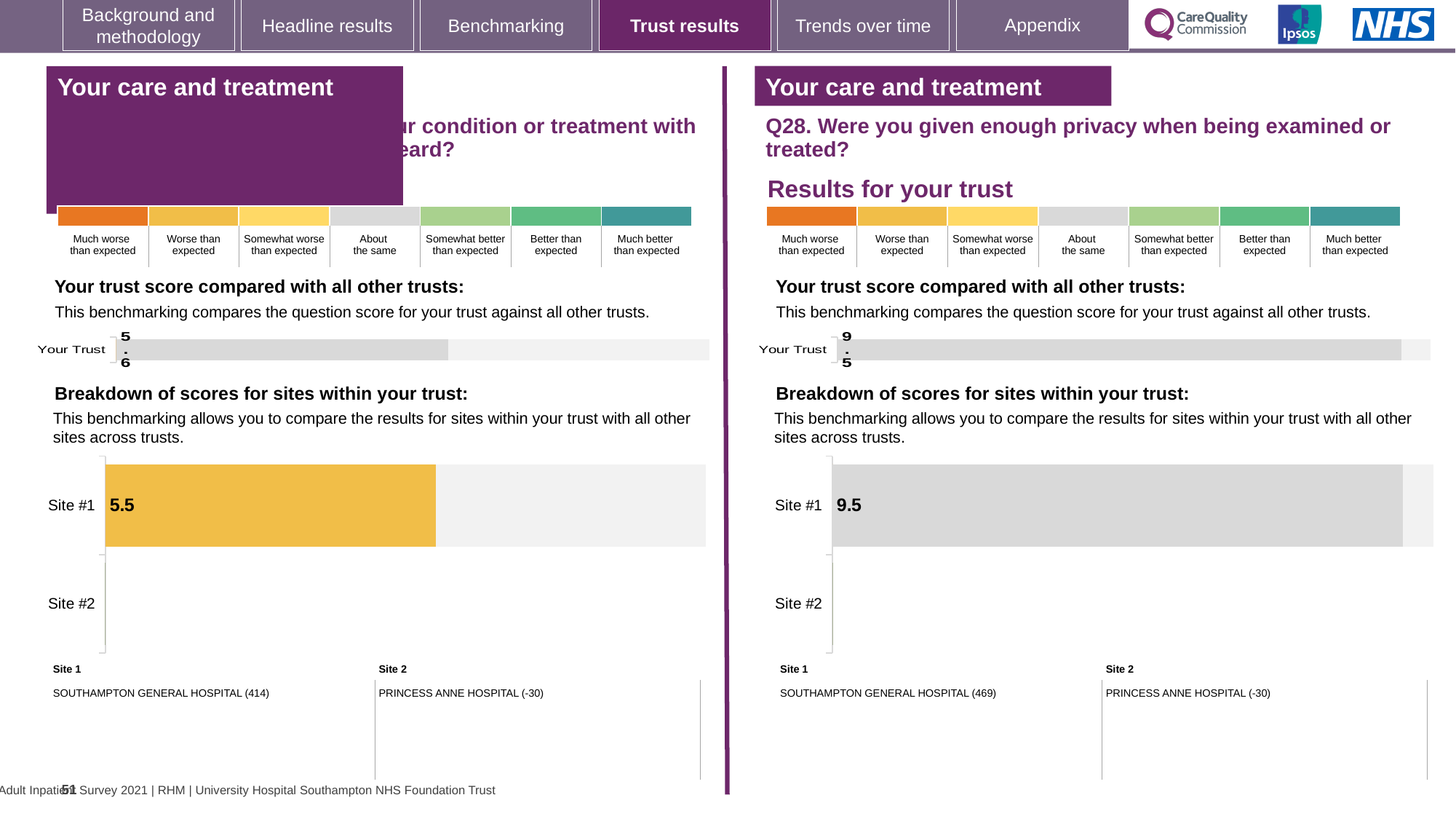
What is the difference between the Your Trust score on the right-hand Q28 trust score chart and the Your Trust score on the left-hand trust score chart? 3.9 How many sites are listed on the right-hand Q28 'Breakdown of scores for sites within your trust' chart? 2 On the left-hand 'Breakdown of scores for sites within your trust' chart, what is the score for Site #1? 5.5 What kind of chart is the 'Breakdown of scores for sites within your trust' chart on the right-hand side? Bar chart On the right-hand Q28 'Breakdown of scores for sites within your trust' chart, what colour is the Site #1 bar? Grey On the left-hand 'Your trust score compared with all other trusts' chart, what is the score shown for Your Trust? 5.6 On the left-hand 'Breakdown of scores for sites within your trust' chart, what colour is the Site #1 bar? Yellow On the right-hand Q28 'Breakdown of scores for sites within your trust' chart, what is the score for Site #1? 9.5 On the left-hand side of the slide, what is the difference between the Your Trust score and the Site #1 score? 0.1 Which is larger: the Your Trust score on the left-hand trust score chart or the Your Trust score on the right-hand Q28 trust score chart? The right-hand Q28 chart On the right-hand Q28 'Your trust score compared with all other trusts' chart, what is the score shown for Your Trust? 9.5